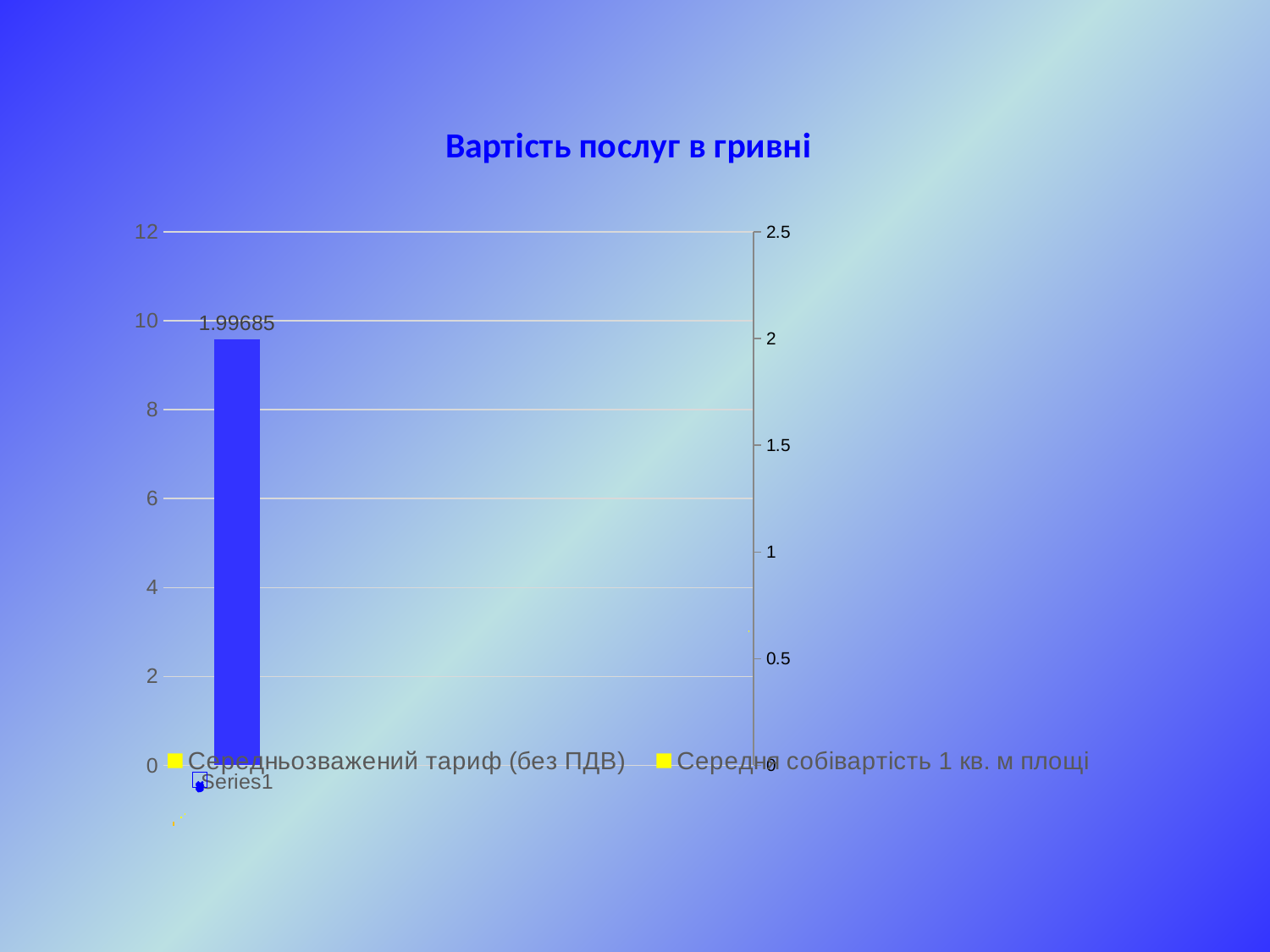
What value is printed as the data label on the bar in the chart? 1.99685 What kind of chart is shown on the slide? bar chart How many bars are plotted in the chart? 1 What is the title of the chart? Вартість послуг в гривні How many entries does the chart legend list? 2 Is the labelled bar value greater or less than 2.5? less What is the highest tick value shown on the left vertical axis? 12 Is the labelled bar value greater or less than 1.5? greater